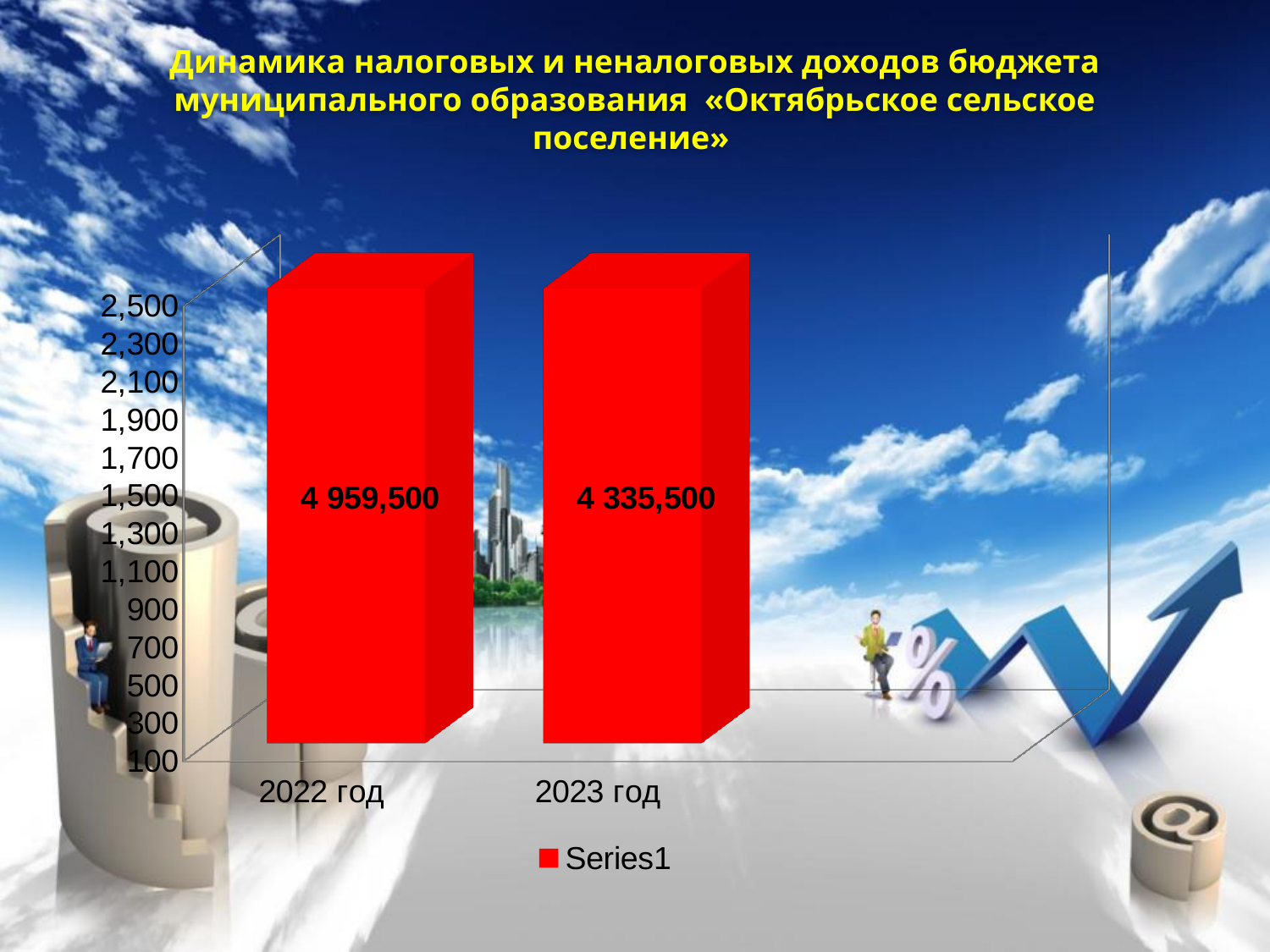
What is the name of the series listed in the legend? Series1 Do the values rise or fall from 2022 год to 2023 год? fall How many categories are shown on the x axis? 2 What value is shown for 2022 год? 4 959,500 Which year has the lowest value? 2023 год How many series does the legend list? 1 Which is larger, the value for 2022 год or for 2023 год? 2022 год Which year has the highest value? 2022 год What colour are the bars in the chart? red What is the difference between the values for 2022 год and 2023 год? 624,000 What value is shown for 2023 год? 4 335,500 What kind of chart is shown on the slide? bar chart